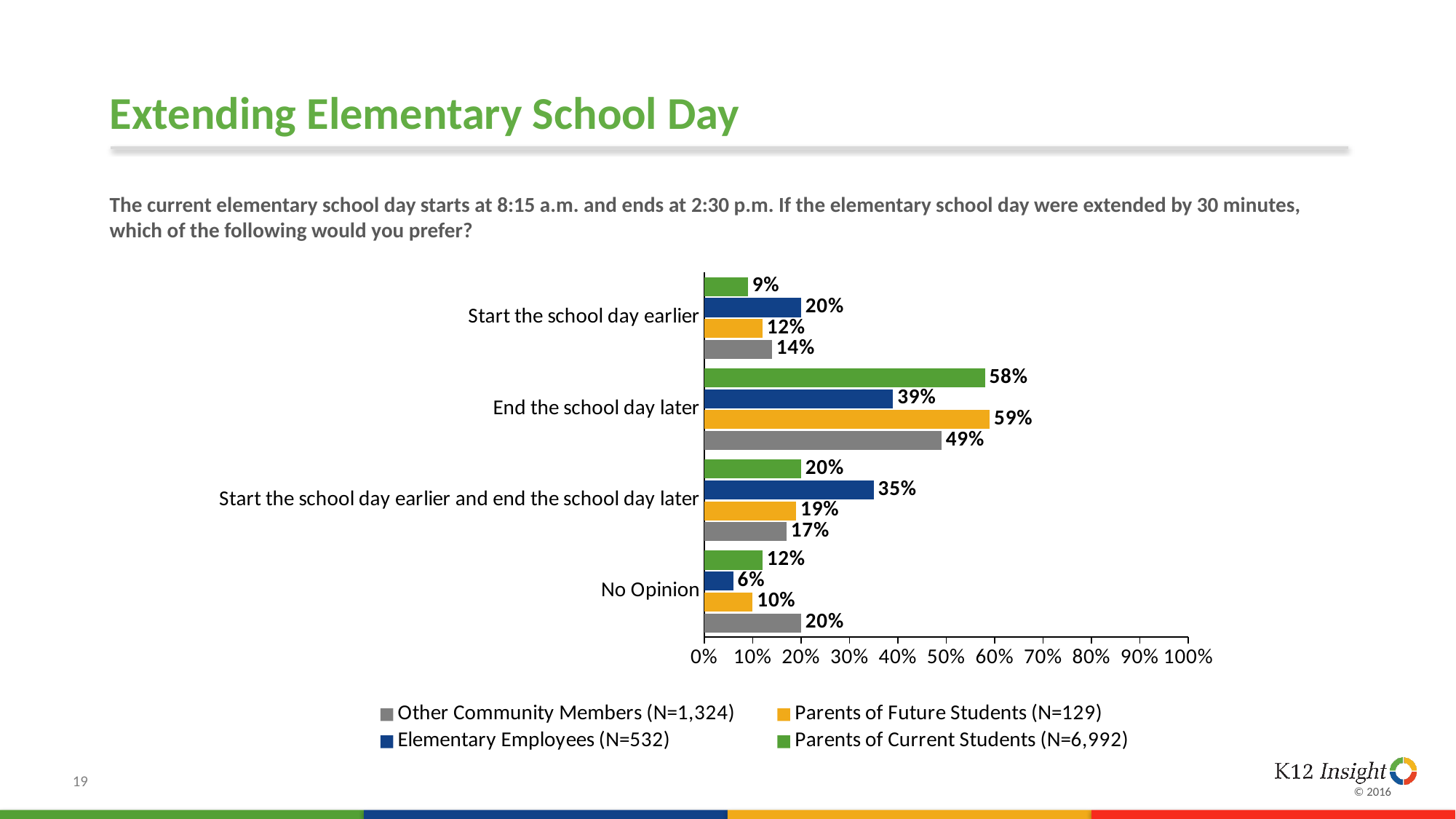
What percentage of Other Community Members have no opinion? 20% For 'Start the school day earlier', which is larger: Elementary Employees or Other Community Members? Elementary Employees Which colour represents Parents of Current Students in the chart? Green Which group has the lowest percentage for 'No Opinion'? Elementary Employees What kind of chart is shown on the slide? Bar chart What percentage of Parents of Current Students prefer to end the school day later? 58% How many response categories are shown on the chart? 4 How many series does the legend list? 4 What is the difference between Parents of Current Students and Elementary Employees for 'End the school day later'? 19 percentage points What percentage of Elementary Employees prefer to start the school day earlier and end the school day later? 35% What percentage of Parents of Future Students prefer to start the school day earlier? 12% Which group has the highest percentage for 'End the school day later'? Parents of Future Students